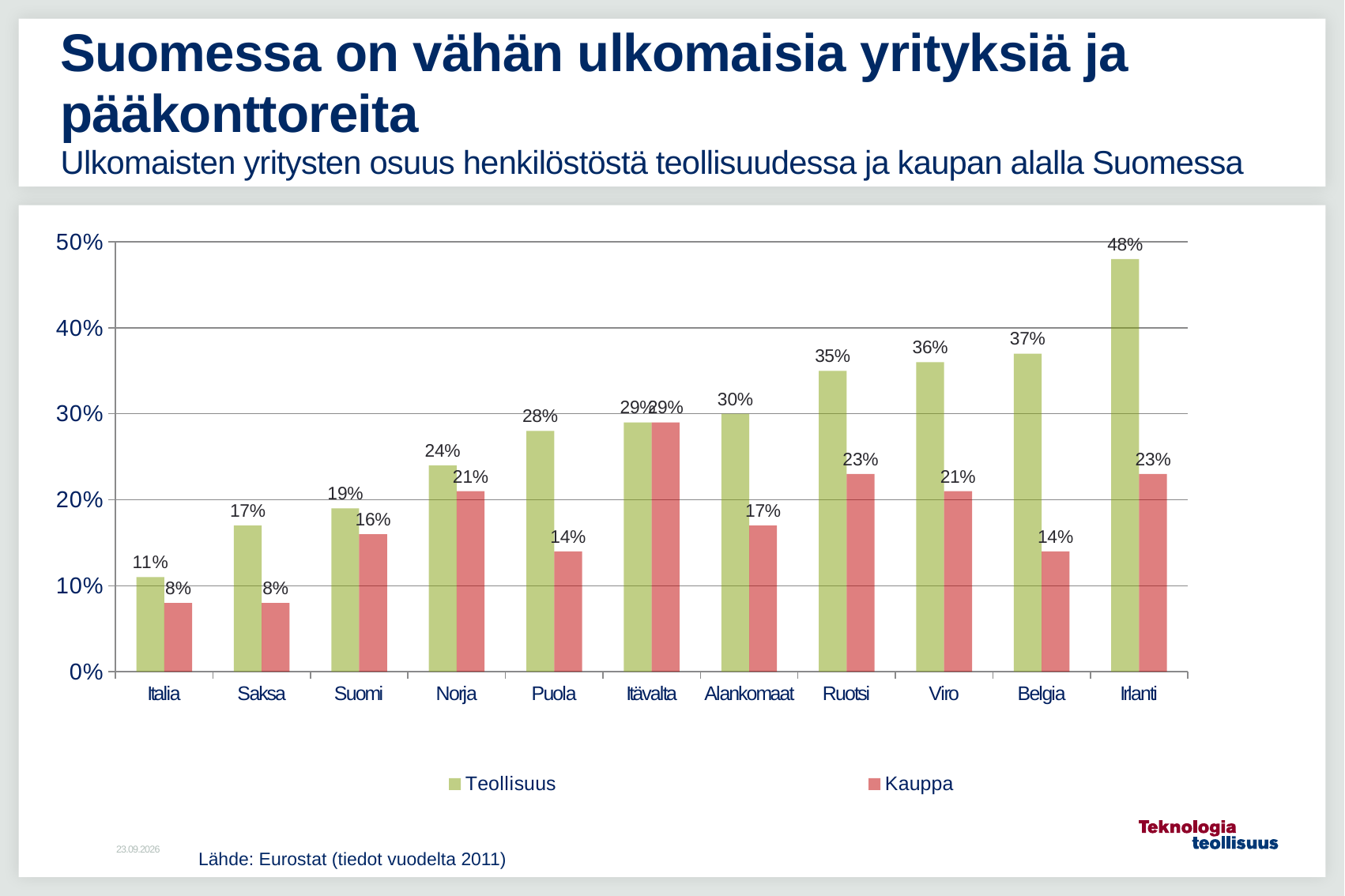
How many countries are shown on the x axis? 11 Which colour represents the Kauppa series in the legend? Red Do the Teollisuus values rise or fall from Italia to Irlanti along the x axis? Rise Is the Teollisuus value for Viro greater or less than 30%? greater Which country has the highest Teollisuus value? Irlanti How many series does the legend list? 2 What is the difference between the Teollisuus and Kauppa values for Belgia? 23% Which is larger for Puola: the Teollisuus value or the Kauppa value? Teollisuus What is the Kauppa value for Ruotsi? 23% What kind of chart is shown on the slide? Bar chart What is the Teollisuus value for Suomi? 19% Which country has the lowest Teollisuus value? Italia